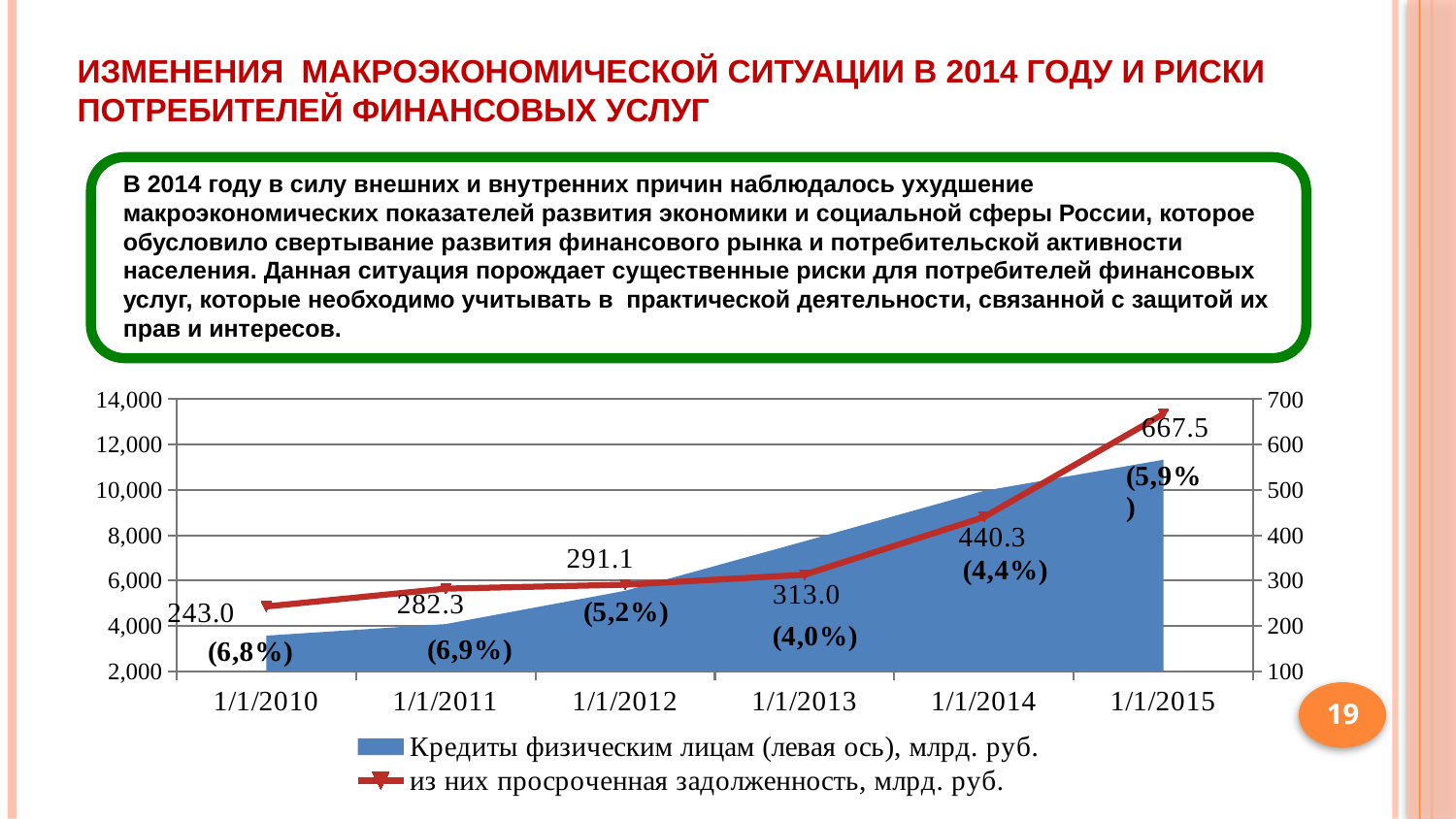
Is the value of credits to individuals (Кредиты физическим лицам) at 1/1/2015 greater or less than 10,000? greater What is the value of overdue debt (из них просроченная задолженность) at 1/1/2015? 667.5 Which date has the larger overdue debt, 1/1/2011 or 1/1/2012? 1/1/2012 At which date is the overdue debt highest? 1/1/2015 What is the value of overdue debt at 1/1/2010? 243.0 Does the overdue debt line rise or fall from 1/1/2010 to 1/1/2015? rise What is the value of overdue debt at 1/1/2013? 313.0 How many series does the chart legend list? 2 How many dates are shown on the x axis of the chart? 6 What percentage is shown in parentheses under the overdue debt value at 1/1/2010? (6,8%) At which date is the overdue debt lowest? 1/1/2010 What is the difference in overdue debt between 1/1/2015 and 1/1/2014? 227.2